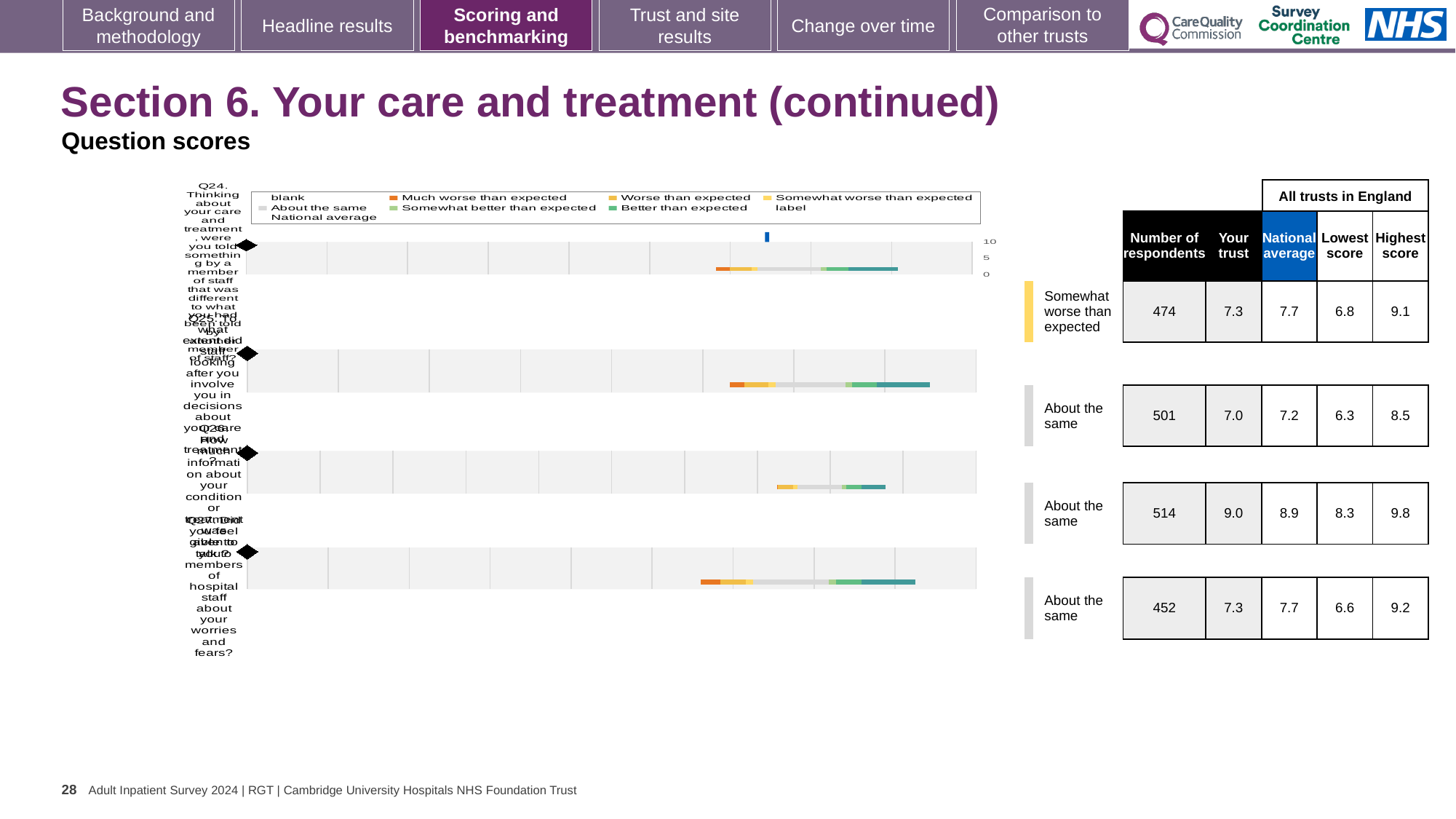
What kind of chart is used to show the question scores on this slide? bar chart Which question has the lowest number of respondents? Q27 How many entries does the chart legend list? 9 What is the difference between the highest score and the lowest score for Q26? 1.5 What is the 'Your trust' score for Q24 (being told something different by a member of staff)? 7.3 How many respondents answered Q25 (involvement in decisions about care and treatment)? 501 What is the difference between the national average and the 'Your trust' score for Q25? 0.2 What is the national average score for Q27 (opportunity to talk to staff about worries and fears)? 7.7 How many questions (rows) are plotted in the chart? 4 Which question has the highest 'Your trust' score? Q26 For Q24, which is larger: the 'Your trust' score or the national average? National average Which benchmark category is Q24 placed in? Somewhat worse than expected